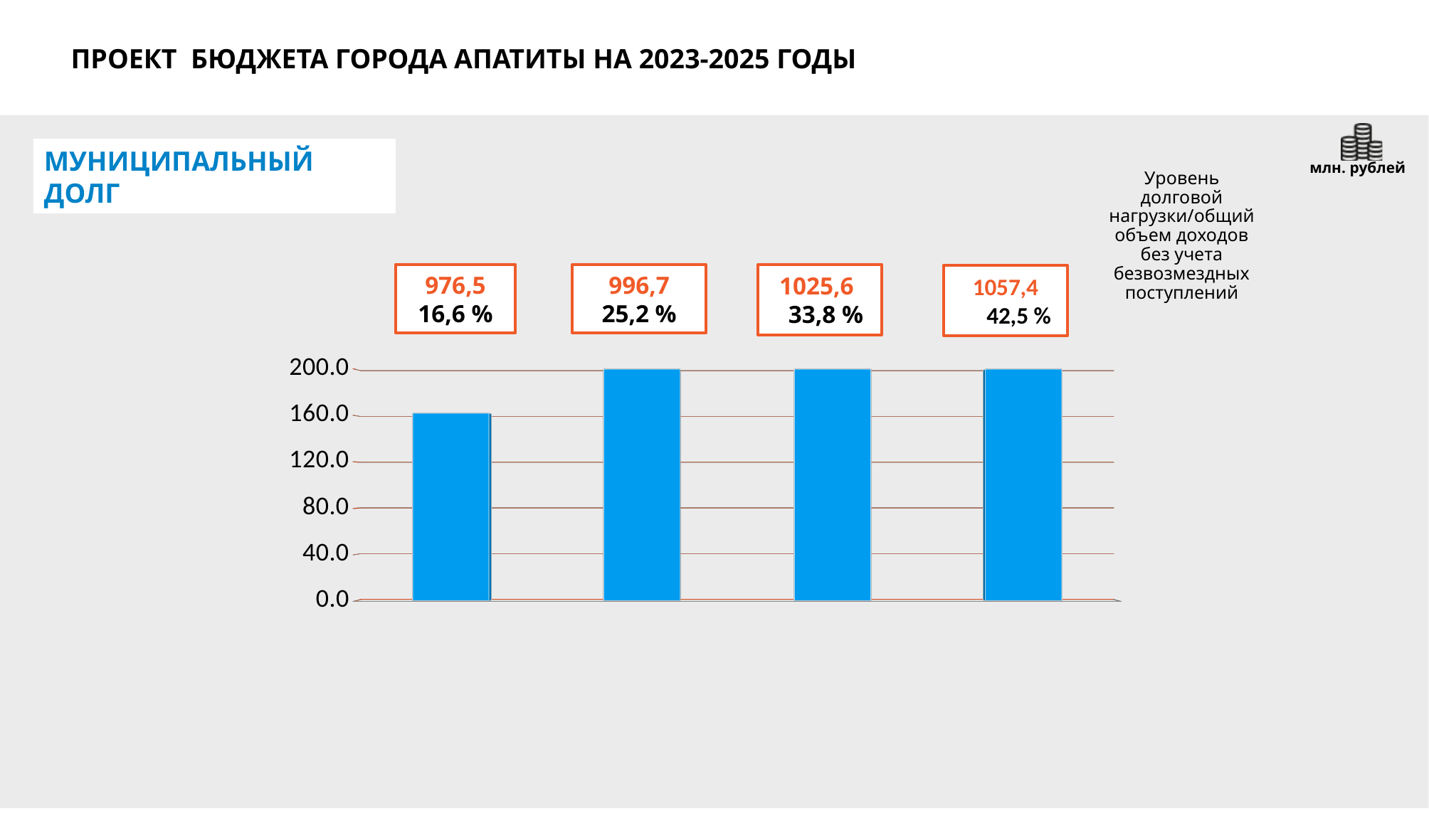
What kind of chart is shown on the slide? bar chart Is the value of the first bar greater or less than 120? greater Which is larger, the first bar or the second bar? the second bar What percentage is shown in the box above the fourth bar? 42,5 % What percentage is shown in the box above the first bar? 16,6 % What unit of measurement is indicated for the chart? млн. рублей Do the bar values rise or fall from the first bar to the second bar? rise Which bar is the lowest in the chart? the first bar What is the highest value shown on the vertical axis? 200.0 Is the value of the second bar greater or less than 160? greater Is the value of the first bar greater or less than 200? less How many bars does the chart contain? 4